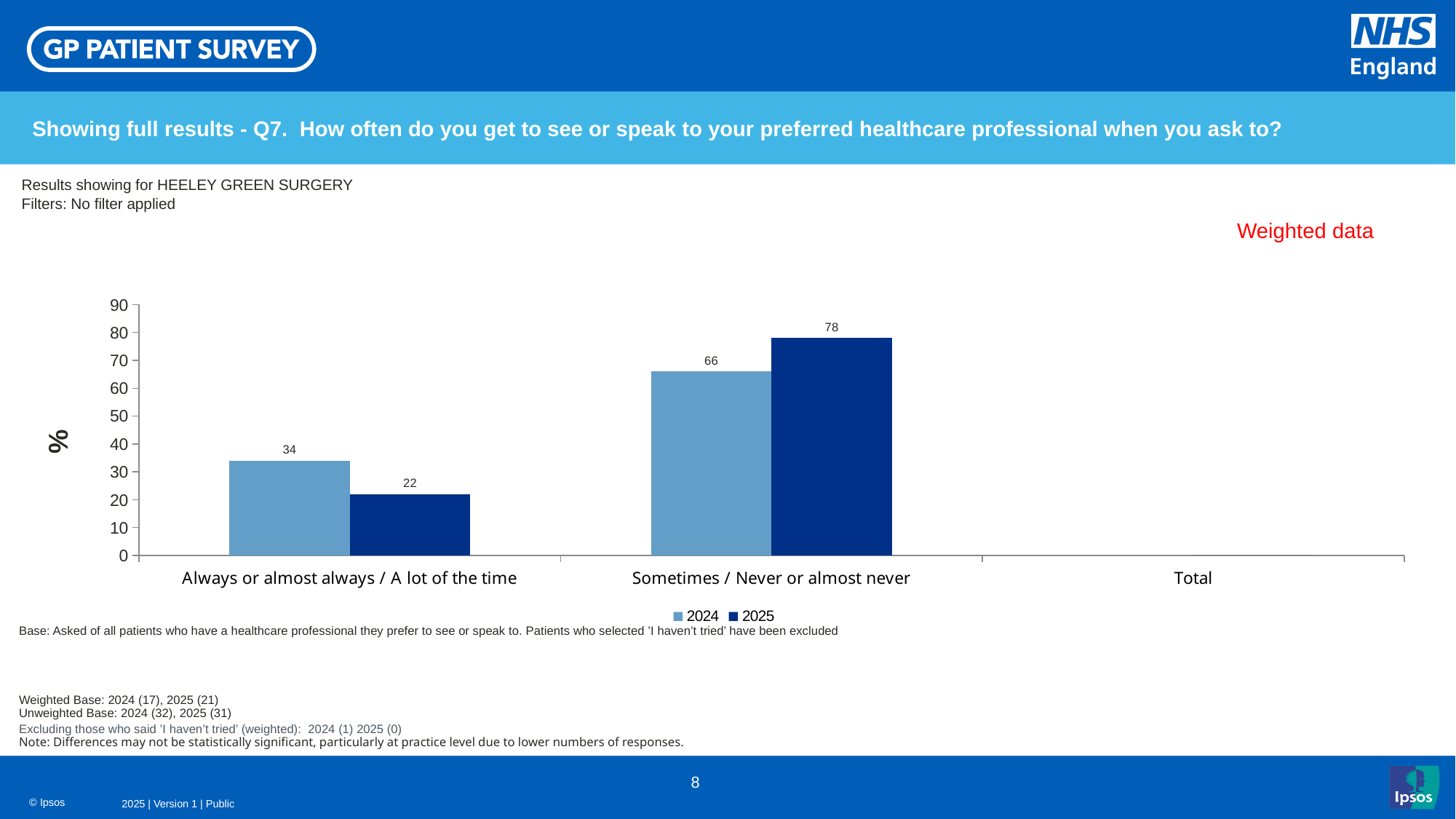
What is the difference between the 2024 and 2025 values for 'Always or almost always / A lot of the time'? 12 Which bar has the highest value on the chart? 2025, Sometimes / Never or almost never Which practice are the results shown for? HEELEY GREEN SURGERY What is the 2025 value for 'Always or almost always / A lot of the time'? 22 What kind of chart is shown on the slide? Bar chart For 'Always or almost always / A lot of the time', which year has the larger value, 2024 or 2025? 2024 What is the 2024 value for 'Sometimes / Never or almost never'? 66 What is the difference between the 2025 and 2024 values for 'Sometimes / Never or almost never'? 12 What is the 2024 value for 'Always or almost always / A lot of the time'? 34 What is the 2025 value for 'Sometimes / Never or almost never'? 78 How many series does the legend list? 2 Which bar has the lowest value on the chart? 2025, Always or almost always / A lot of the time